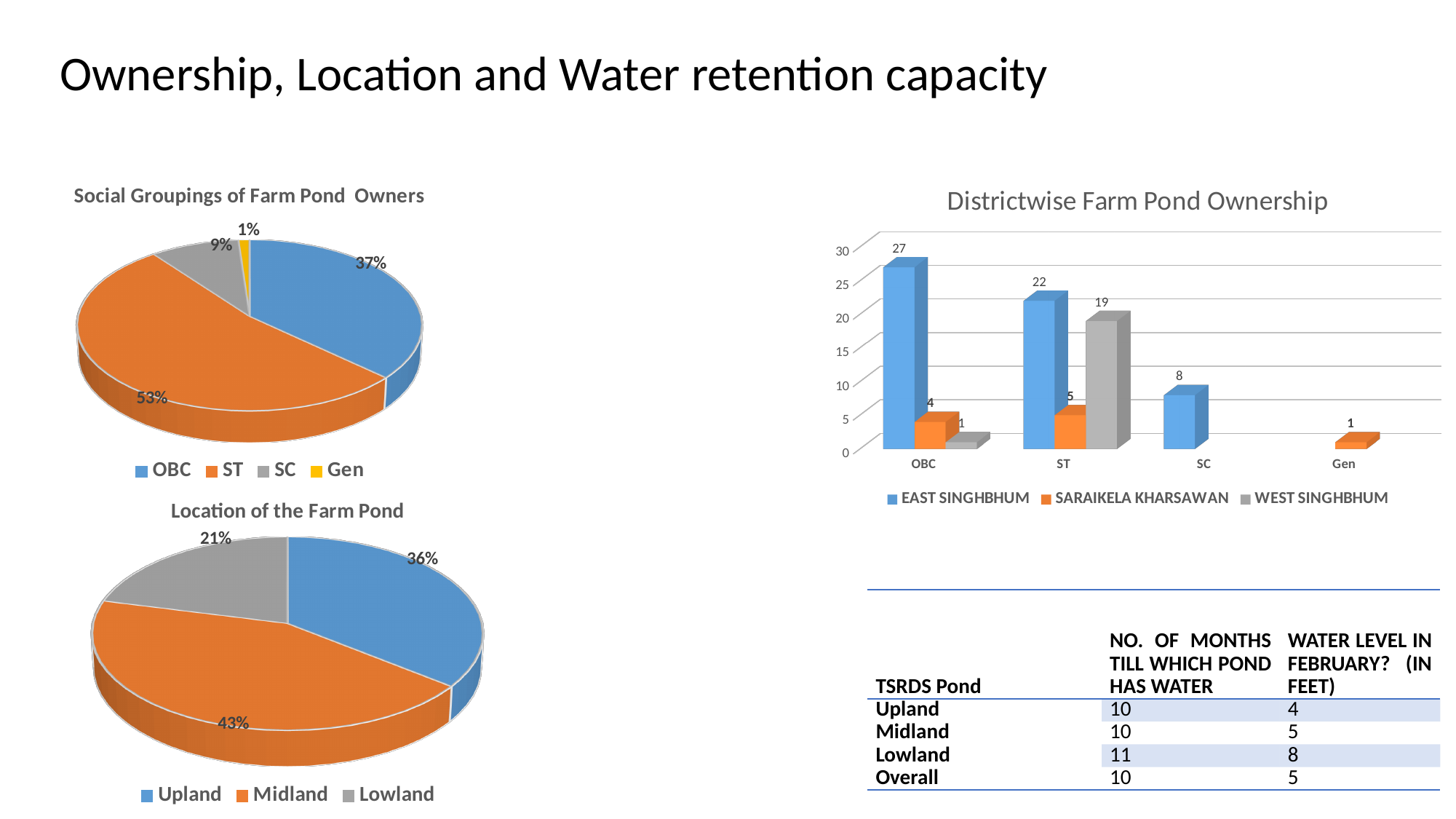
In the 'Districtwise Farm Pond Ownership' chart, which is larger: EAST SINGHBHUM for OBC or EAST SINGHBHUM for ST? EAST SINGHBHUM for OBC In the 'Location of the Farm Pond' pie chart, what is the difference between the Upland and Lowland shares? 15% In the 'Districtwise Farm Pond Ownership' chart, what kind of chart is used? Bar chart In the 'Location of the Farm Pond' pie chart, what percentage of ponds are in Midland? 43% In the 'Social Groupings of Farm Pond Owners' pie chart, how many groups are shown in the legend? 4 In the 'Districtwise Farm Pond Ownership' chart, how many series does the legend list? 3 In the 'Location of the Farm Pond' pie chart, which location has the largest share? Midland In the 'Districtwise Farm Pond Ownership' chart, what is the difference between EAST SINGHBHUM and SARAIKELA KHARSAWAN in the ST category? 17 In the 'Social Groupings of Farm Pond Owners' pie chart, which group has the smallest share? Gen In the 'Districtwise Farm Pond Ownership' chart, what is the value for WEST SINGHBHUM in the ST category? 19 In the 'Districtwise Farm Pond Ownership' chart, what is the value for EAST SINGHBHUM in the OBC category? 27 In the 'Social Groupings of Farm Pond Owners' pie chart, what share do ST owners hold? 53%